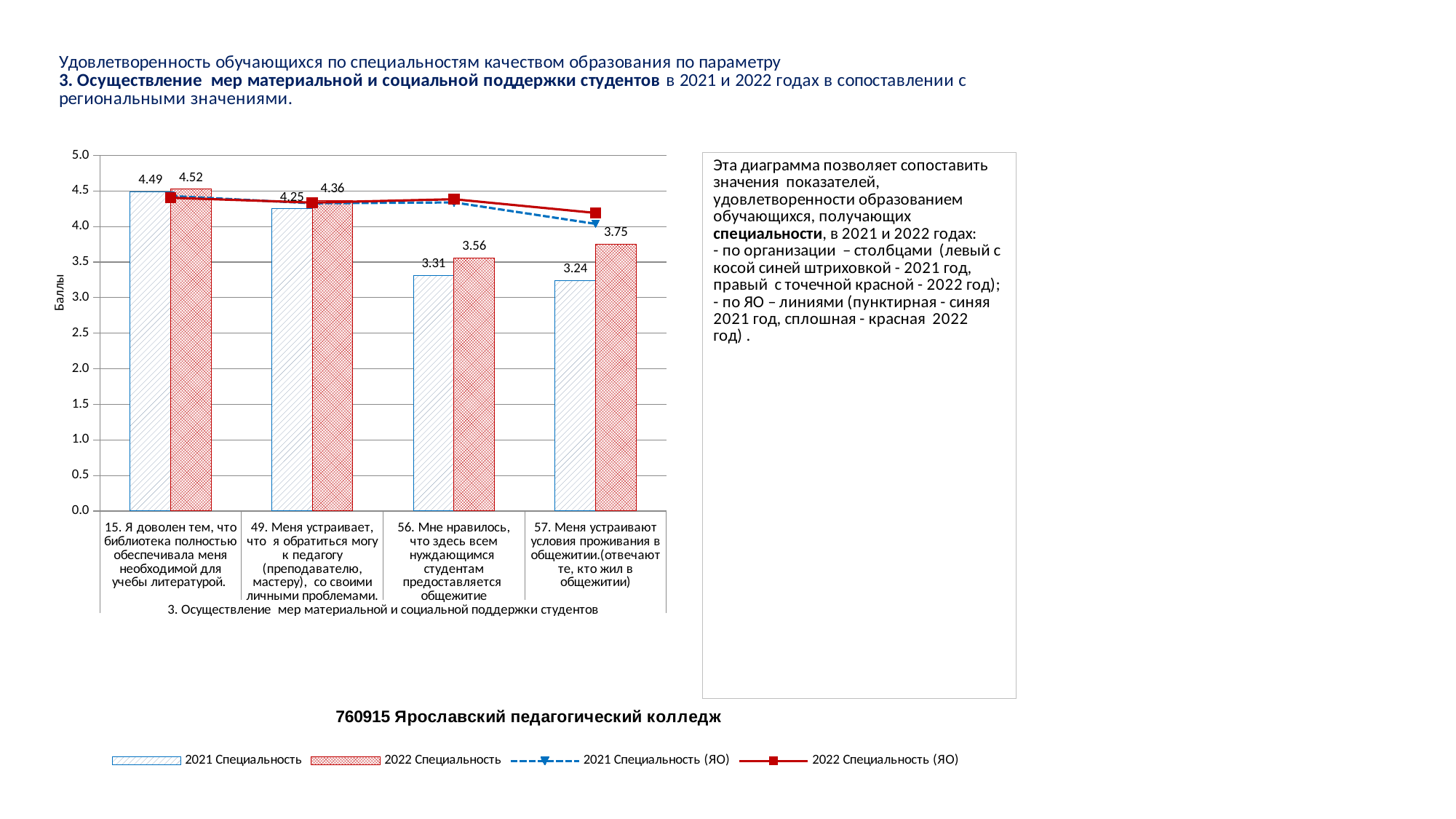
What is the value of the 2021 Специальность bar for item 15 (library provision)? 4.49 Which category has the lowest 2021 Специальность value? 57. Меня устраивают условия проживания в общежитии By how much does the 2022 Специальность value exceed the 2021 Специальность value for item 57? 0.51 How many series does the legend list? 4 How many categories (survey items) are shown on the x axis? 4 What is the value of the 2022 Специальность bar for item 57 (dormitory living conditions)? 3.75 Do the 2021 Специальность bar values rise or fall from left to right along the x axis? fall For item 56 (dormitory provided to students in need), which is larger: the 2021 Специальность value or the 2022 Специальность value? 2022 Специальность What kind of chart is used for the Специальность values for 2021 and 2022? bar chart Which category has the highest 2022 Специальность value? 15. Я доволен тем, что библиотека полностью обеспечивала меня необходимой для учебы литературой. Is the 2022 Специальность (ЯО) line value for item 57 greater or less than 4.0? greater What is the value of the 2022 Специальность bar for item 49 (approaching a teacher with personal problems)? 4.36